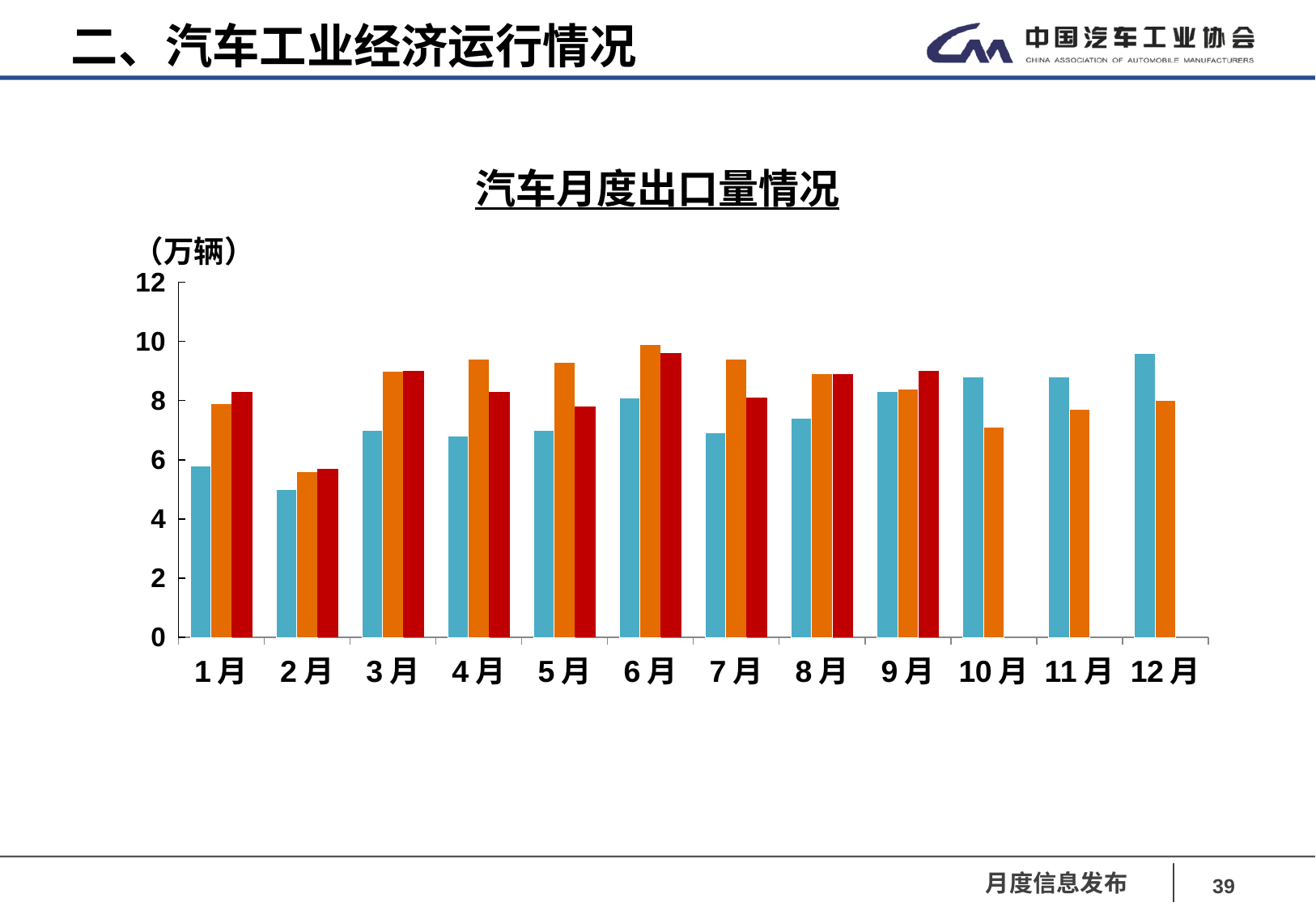
In which month is the orange bar the lowest? 2月 Is the value of the blue bar for 2月 greater or less than 6? less How many bars are plotted for 1月? 3 How many bars are plotted for 12月? 2 Is the value of the blue bar for 12月 greater or less than 8? greater Which is larger, the orange bar for 6月 or the orange bar for 10月? 6月 What is the title of the chart? 汽车月度出口量情况 How many months are shown along the x axis of the chart? 12 What kind of chart is shown on the slide? bar chart In which month is the blue bar the highest? 12月 What unit is shown on the chart's vertical axis? 万辆 Is the value of the orange bar for 6月 greater or less than 8? greater